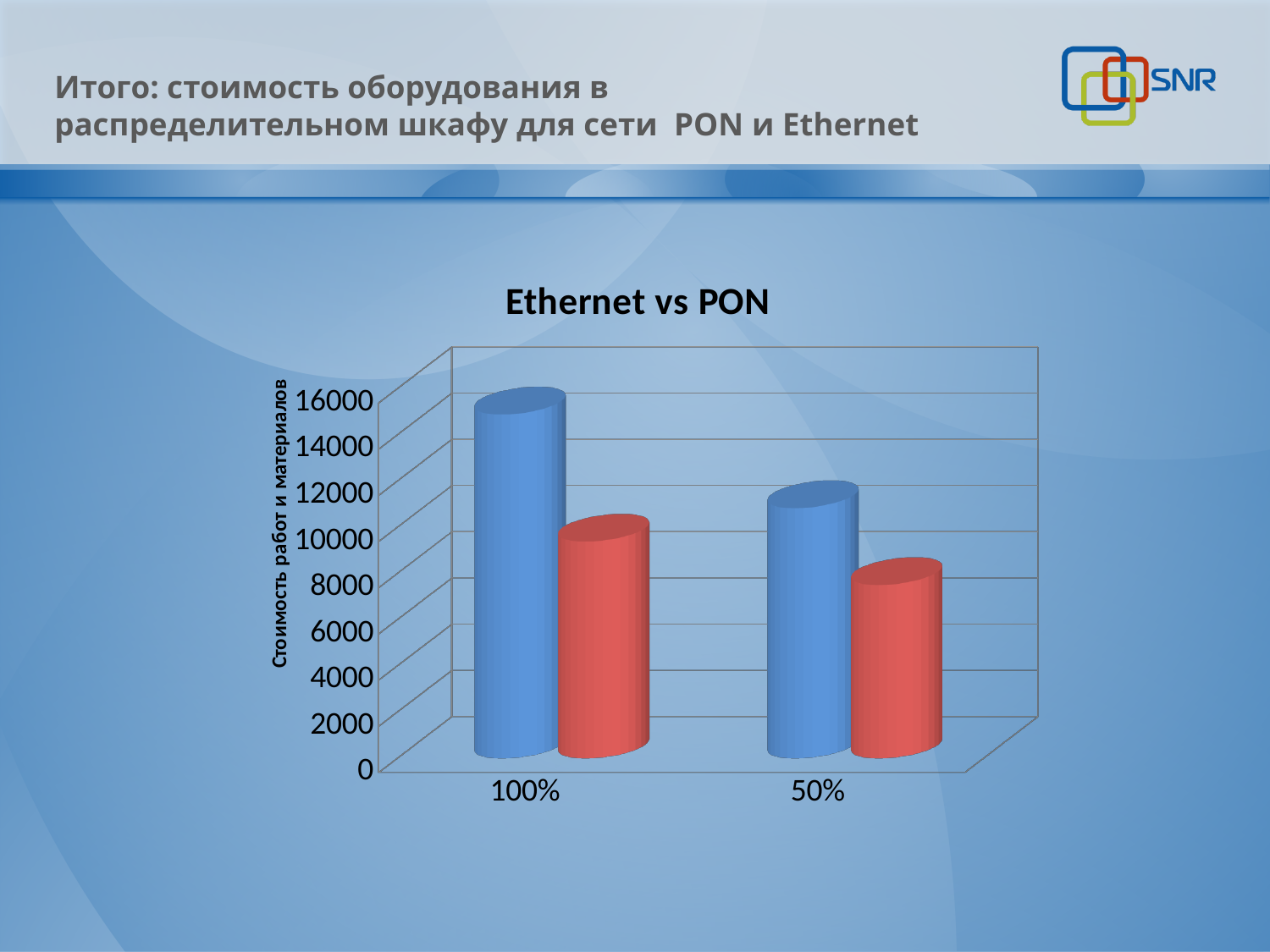
Is the value of the blue bar for 50% greater or less than 10000? greater Do the blue bars rise or fall from the 100% category to the 50% category? fall What kind of chart is shown on the slide? bar chart What is the title of the chart? Ethernet vs PON Is the blue bar taller for the 100% category or the 50% category? 100% Is the value of the blue bar for 100% greater or less than 14000? greater Which category has the tallest bar in the chart? 100% Is the value of the red bar for 50% greater or less than 10000? less In the 100% category, which bar is taller, the blue one or the red one? blue Is the red bar taller for the 100% category or the 50% category? 100% How many categories are shown on the x axis of the chart? 2 What is the label of the vertical axis of the chart? Стоимость работ и материалов